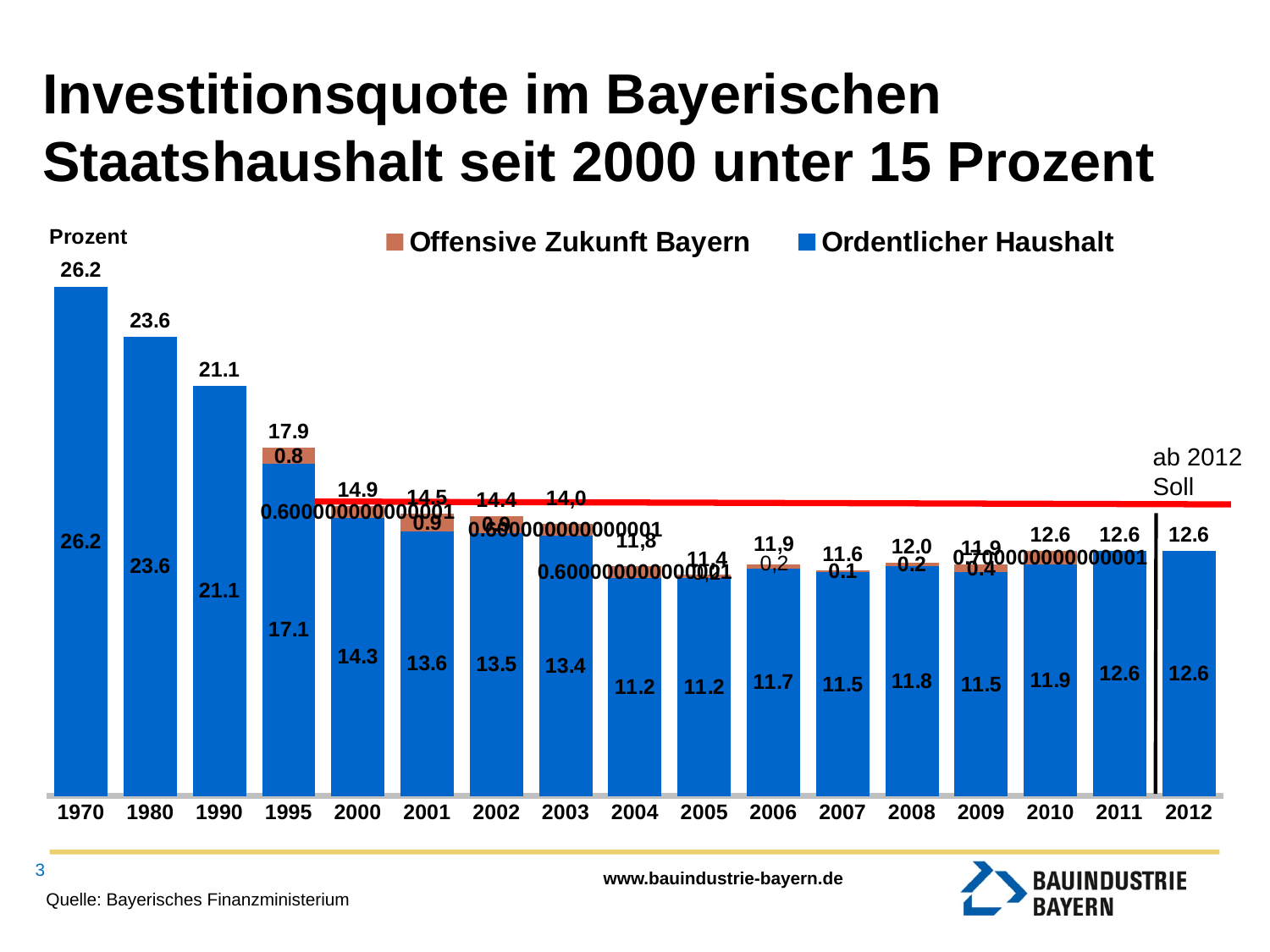
How many years are shown on the x axis? 17 What is the value of Ordentlicher Haushalt for 2012? 12.6 Which is larger, the Ordentlicher Haushalt value for 2006 or for 2007? 2006 What is the value of Offensive Zukunft Bayern for 1995? 0.8 What is the difference between the Ordentlicher Haushalt values for 1970 and 1980? 2.6 What kind of chart is shown on the slide? bar chart How many series does the legend list? 2 What is the value of Ordentlicher Haushalt for 1970? 26.2 What is the total of the stacked bar for 1995? 17.9 What is the value of Ordentlicher Haushalt for 2000? 14.3 Which year has the highest value for Ordentlicher Haushalt? 1970 Do the Ordentlicher Haushalt values rise or fall from 1970 to 2000? fall